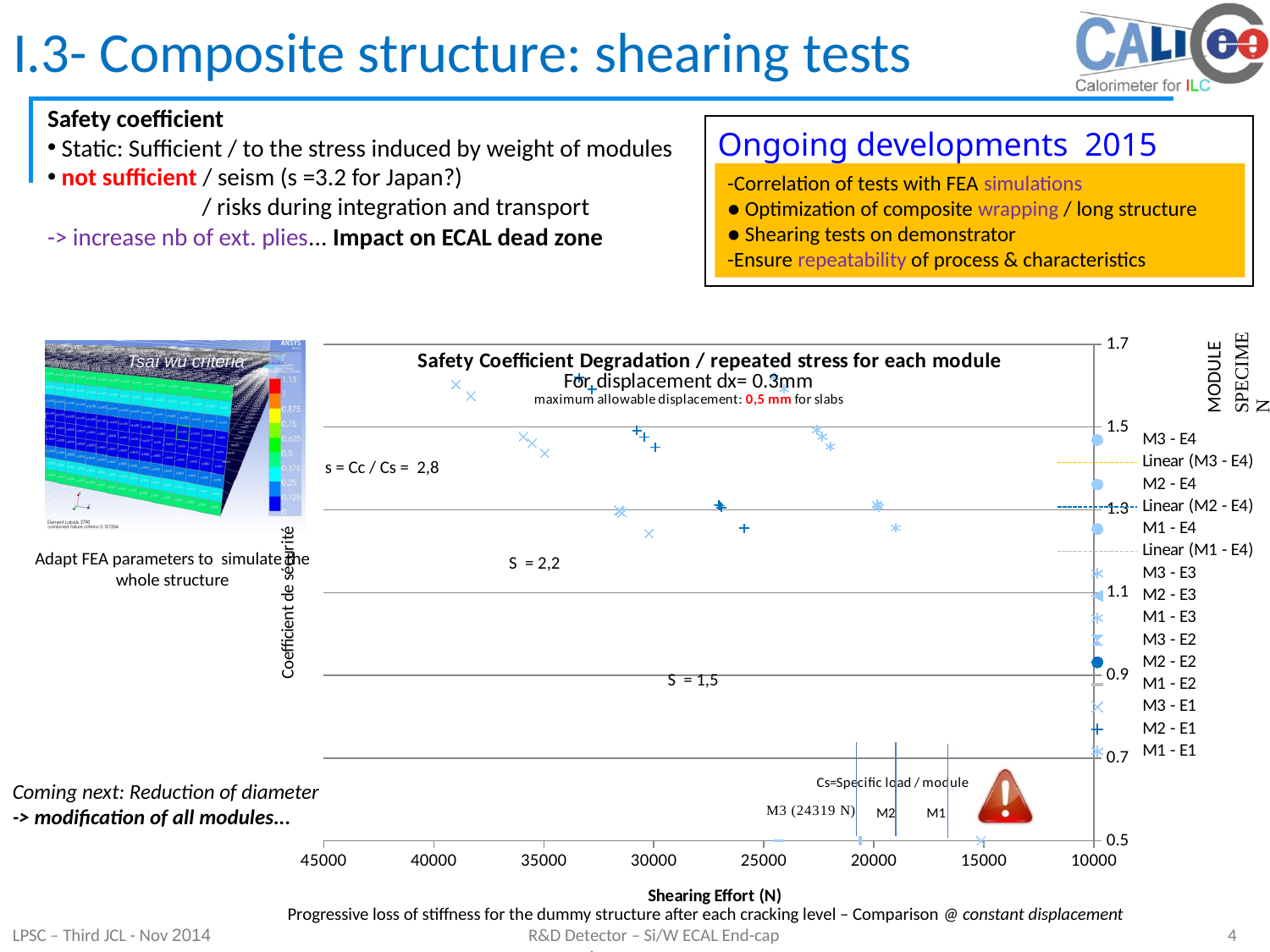
What kind of chart is shown on the slide? scatter chart What is the highest value shown on the y axis of the chart? 1.7 What is the title of the chart? Safety Coefficient Degradation / repeated stress for each module What is the label of the x axis of the chart? Shearing Effort (N) What is the lowest value shown on the y axis of the chart? 0.5 What specific load per module is annotated for M3 on the chart? 24319 N How many entries does the legend of the chart list? 15 What is the largest value shown on the x axis of the chart? 45000